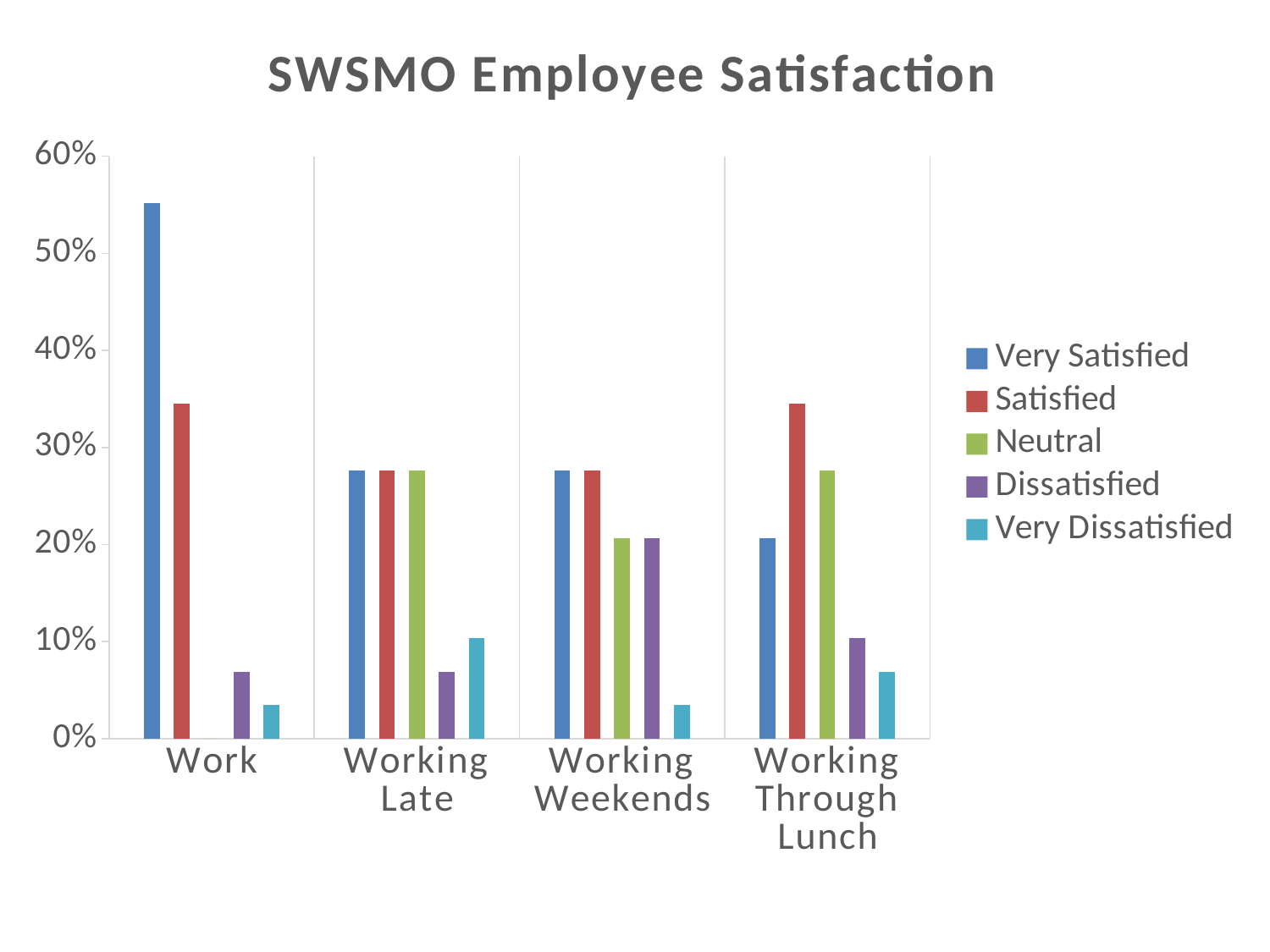
What kind of chart is shown on the slide? bar chart Is the Very Satisfied value for Work greater or less than 50%? greater What is the title of the chart? SWSMO Employee Satisfaction For Working Through Lunch, which is larger: Satisfied or Very Satisfied? Satisfied How many series does the legend list? 5 Which category has the highest Very Satisfied value? Work Is the Very Dissatisfied value for Work greater or less than 10%? less For Work, which is larger: Very Satisfied or Satisfied? Very Satisfied Is the Satisfied value for Work greater or less than 30%? greater How many categories are shown on the x axis? 4 Which category has the lowest Very Satisfied value? Working Through Lunch